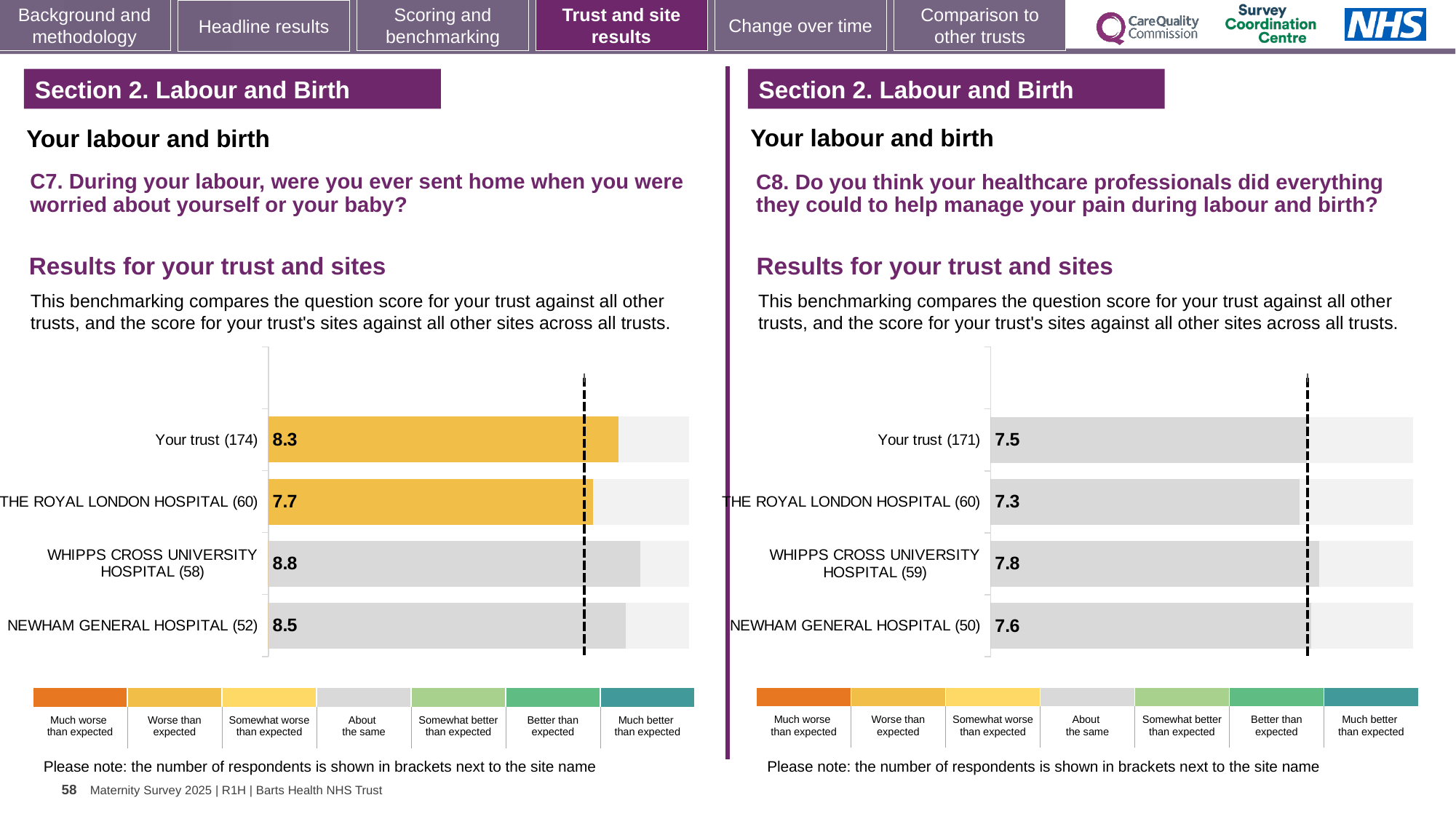
In the C8 chart on the right, what is the score for Your trust? 7.5 In the C7 chart on the left, what is the difference between the scores for WHIPPS CROSS UNIVERSITY HOSPITAL and NEWHAM GENERAL HOSPITAL? 0.3 How many bars are plotted in the C8 chart on the right? 4 In the C7 chart on the left, how many respondents are shown in brackets for NEWHAM GENERAL HOSPITAL? 52 In the C7 chart on the left, what is the score for THE ROYAL LONDON HOSPITAL? 7.7 In the C8 chart on the right, which site or trust has the lowest score? THE ROYAL LONDON HOSPITAL In the C8 chart on the right, what is the score for NEWHAM GENERAL HOSPITAL? 7.6 What type of chart is used in the C7 chart on the left? Bar chart In the C7 chart on the left, which site or trust has the highest score? WHIPPS CROSS UNIVERSITY HOSPITAL In the C8 chart on the right, which is larger, the score for WHIPPS CROSS UNIVERSITY HOSPITAL or the score for THE ROYAL LONDON HOSPITAL? WHIPPS CROSS UNIVERSITY HOSPITAL In the C7 chart on the left, what is the score for Your trust? 8.3 In the C7 chart on the left, which site or trust has the lowest score? THE ROYAL LONDON HOSPITAL